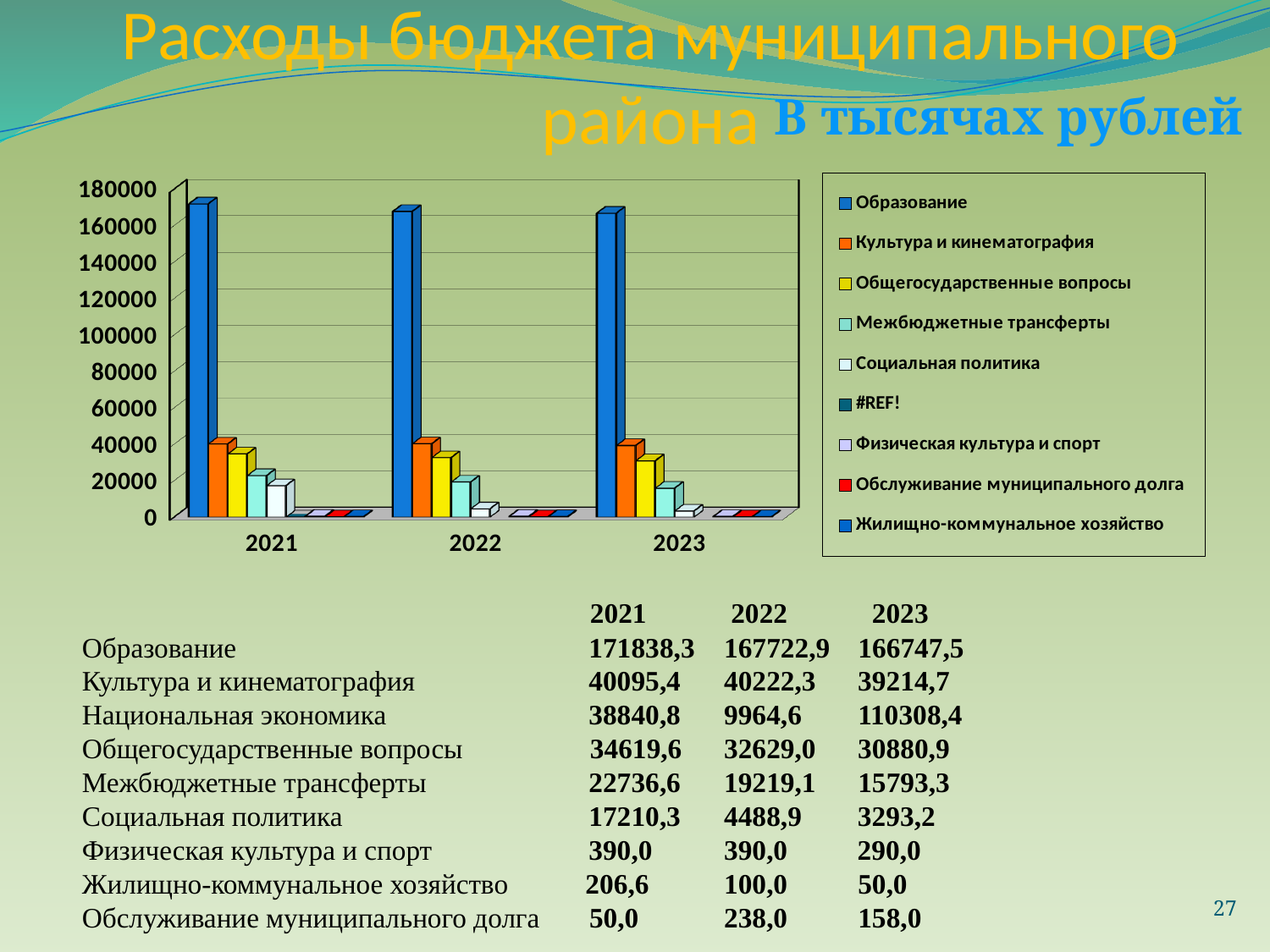
What is the value for Образование in 2021? 171838,3 What is the difference between the Образование values for 2021 and 2023? 5090,8 What kind of chart is shown on the slide? bar chart Is the value for Образование in 2022 greater or less than 160000? greater Which is larger in 2022: Культура и кинематография or Общегосударственные вопросы? Культура и кинематография Is the value for Межбюджетные трансферты in 2023 greater or less than 20000? less What is the value for Социальная политика in 2022? 4488,9 In which year is the value for Образование the highest? 2021 Do the values for Межбюджетные трансферты rise or fall from 2021 to 2023? fall How many years (categories) are shown on the x axis of the chart? 3 How many series does the chart legend list? 9 What is the value for Культура и кинематография in 2023? 39214,7